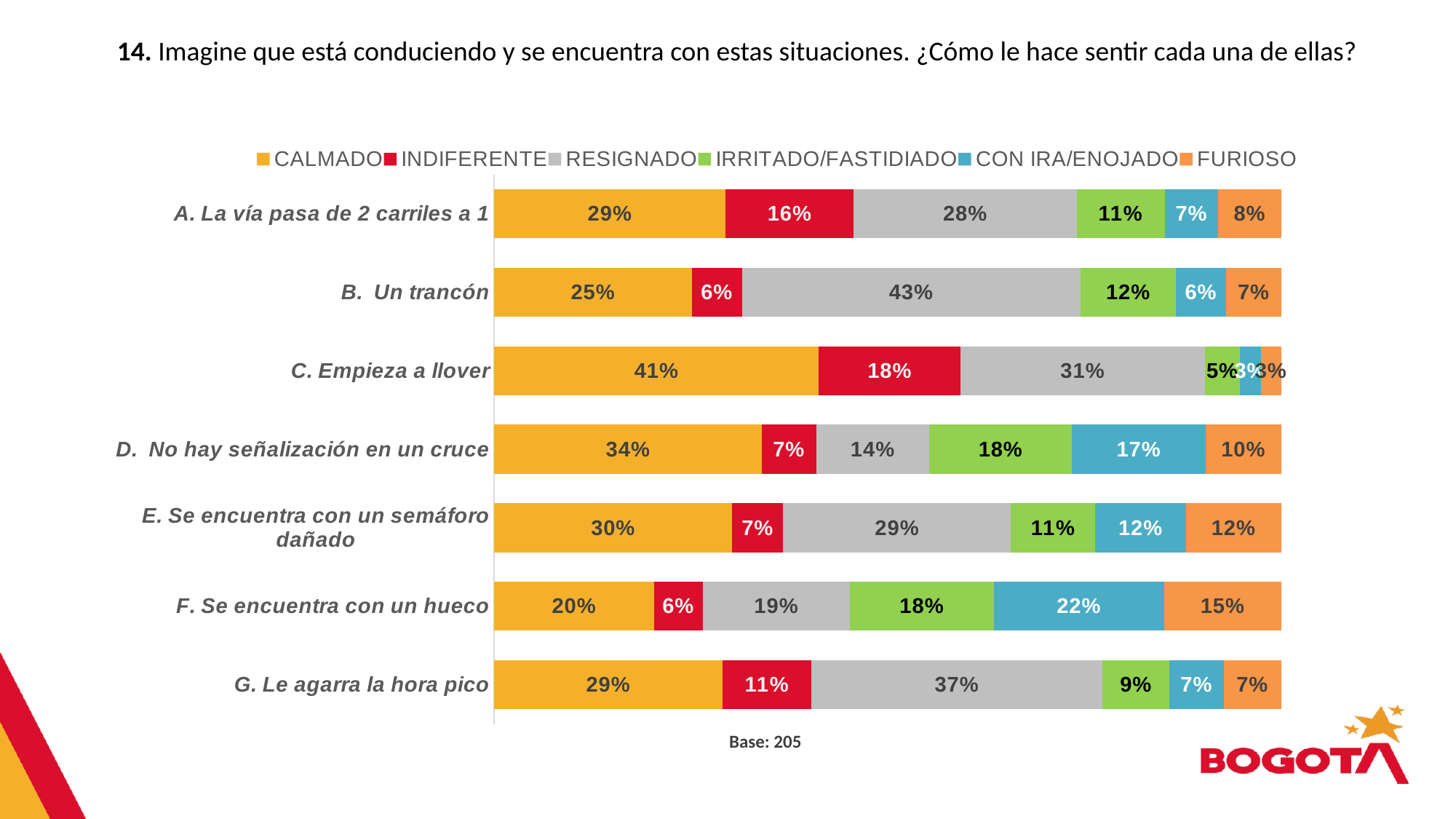
What is the CON IRA/ENOJADO value for "F. Se encuentra con un hueco"? 22% Which situation has the highest RESIGNADO percentage? B. Un trancón How many series does the legend list? 6 Which has the larger FURIOSO value: "F. Se encuentra con un hueco" or "D. No hay señalización en un cruce"? F. Se encuentra con un hueco How many percentage points higher is the RESIGNADO value for "B. Un trancón" than for "A. La vía pasa de 2 carriles a 1"? 15 percentage points Which situation has the lowest CALMADO percentage? F. Se encuentra con un hueco What percentage of respondents answered CALMADO for "B. Un trancón"? 25% What kind of chart is shown on the slide? Stacked bar chart How many situations (categories) are shown in the chart? 7 What is the RESIGNADO value for "G. Le agarra la hora pico"? 37% What is the IRRITADO/FASTIDIADO value for "D. No hay señalización en un cruce"? 18% Which situation has the highest CALMADO percentage? C. Empieza a llover